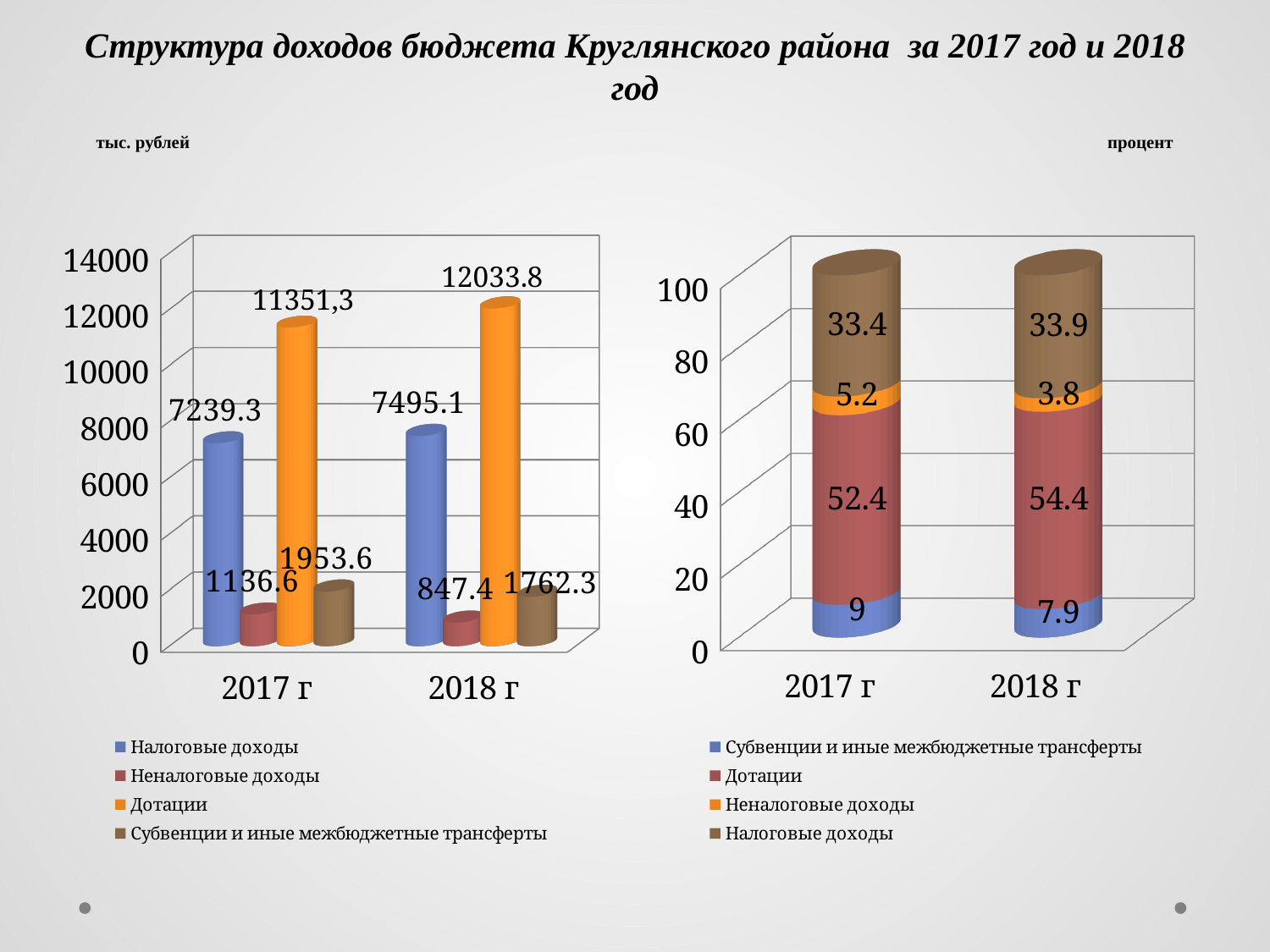
On the right chart (процент), what is the difference between Налоговые доходы in 2018 г and 2017 г? 0.5 What type of chart is the right chart (процент)? Stacked bar chart On the left chart (тыс. рублей), which series has the lowest value in 2017 г? Неналоговые доходы On the left chart (тыс. рублей), what is the difference between Субвенции и иные межбюджетные трансферты in 2017 г and 2018 г? 191.3 On the left chart (тыс. рублей), how many series does the legend list? 4 On the left chart (тыс. рублей), which series has the highest value in 2018 г? Дотации On the left chart (тыс. рублей), what is the value of Налоговые доходы for 2018 г? 7495.1 On the right chart (процент), what is the share of Дотации in 2018 г? 54.4 On the left chart (тыс. рублей), what is the value of Дотации for 2017 г? 11351,3 On the left chart (тыс. рублей), what is the value of Неналоговые доходы for 2018 г? 847.4 On the right chart (процент), what is the value of Субвенции и иные межбюджетные трансферты for 2017 г? 9 On the right chart (процент), is the value of Неналоговые доходы larger in 2017 г or 2018 г? 2017 г